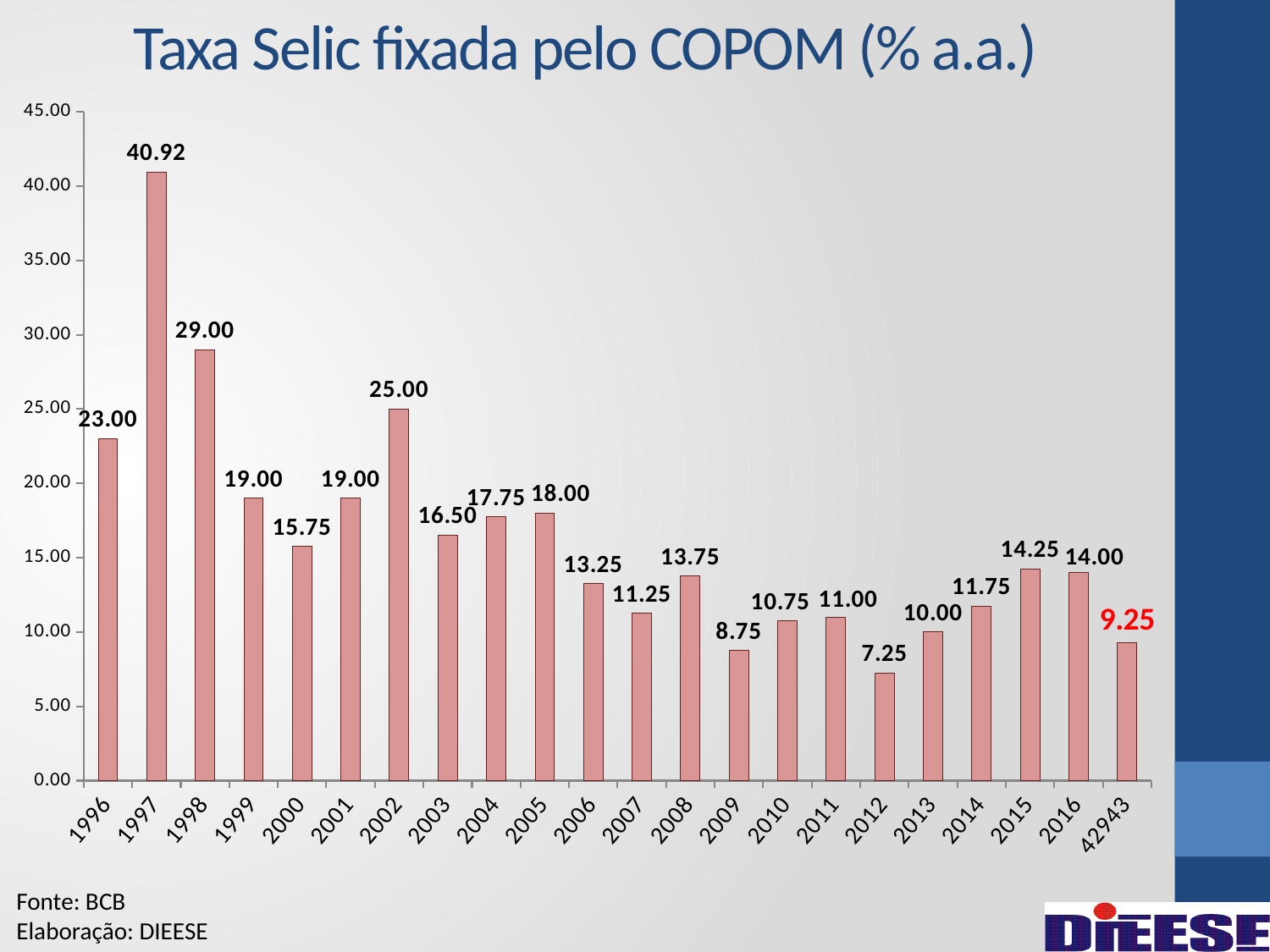
Which year has the highest value? 1997 What is the value shown for the last bar, labelled 42943? 9.25 Which is larger, the value for 2005 or the value for 2004? 2005 How many bars are plotted in the chart? 22 What is the difference between the values for 1997 and 1998? 11.92 What is the value for 2002? 25.00 What is the value for 2012? 7.25 What is the title of the chart? Taxa Selic fixada pelo COPOM (% a.a.) What is the difference between the values for 2015 and 2016? 0.25 What kind of chart is shown on the slide? Bar chart Which year has the lowest value? 2012 What is the value for 1997? 40.92